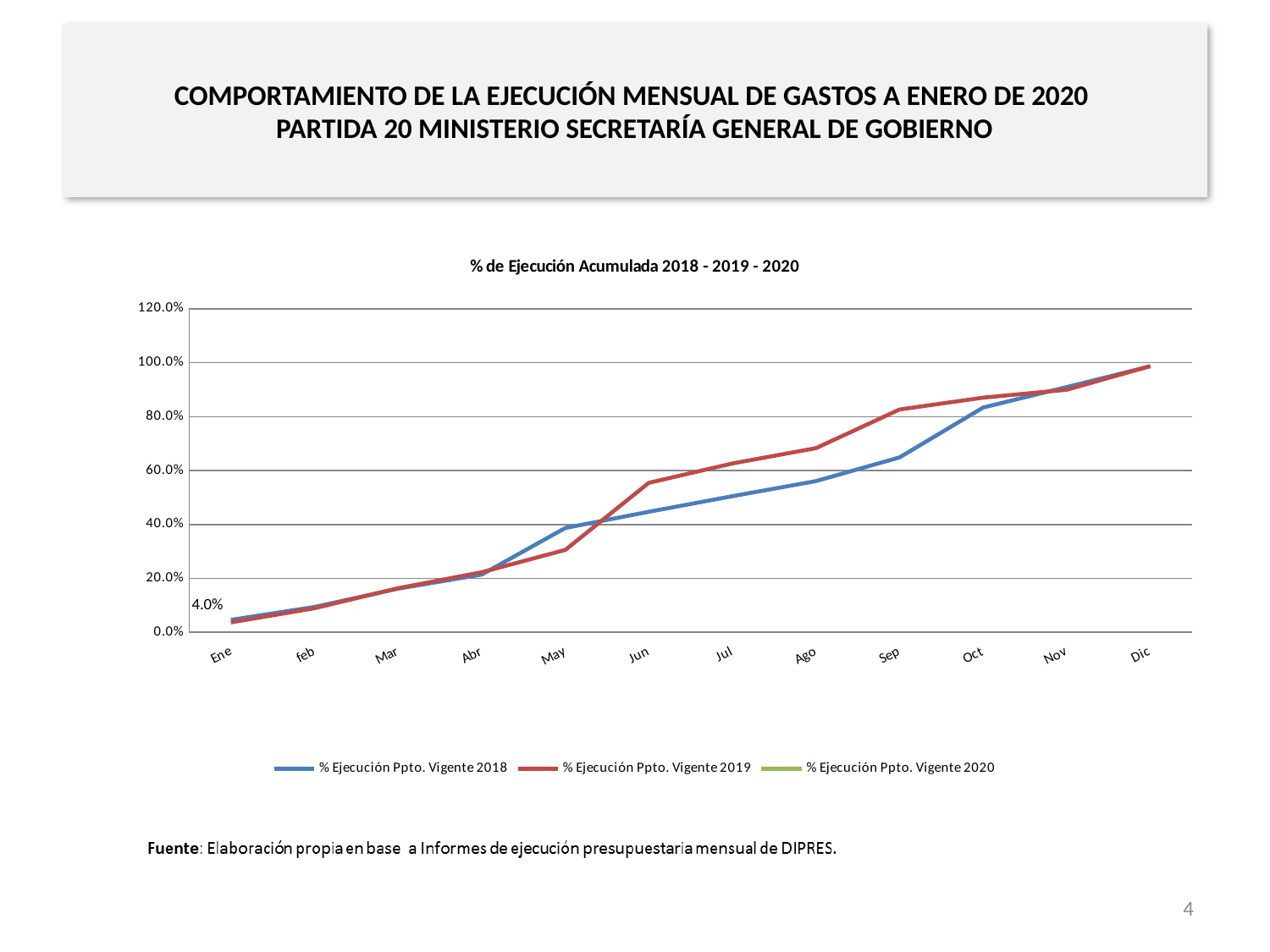
At Sep, which series is larger: % Ejecución Ppto. Vigente 2018 or % Ejecución Ppto. Vigente 2019? % Ejecución Ppto. Vigente 2019 What is the title of the chart? % de Ejecución Acumulada 2018 - 2019 - 2020 In which month does % Ejecución Ppto. Vigente 2019 reach its highest value? Dic Is the value for % Ejecución Ppto. Vigente 2019 at Jun greater or less than 40.0%? greater Which colour represents the series % Ejecución Ppto. Vigente 2019? red How many months are shown along the x axis? 12 What data label is printed on the chart near Ene? 4.0% Is the value for % Ejecución Ppto. Vigente 2018 at Jul greater or less than 60.0%? less At May, which series is larger: % Ejecución Ppto. Vigente 2018 or % Ejecución Ppto. Vigente 2019? % Ejecución Ppto. Vigente 2018 Do the values for % Ejecución Ppto. Vigente 2018 rise or fall from Ene to Dic? rise What kind of chart is shown on the slide? line chart How many series does the legend list? 3